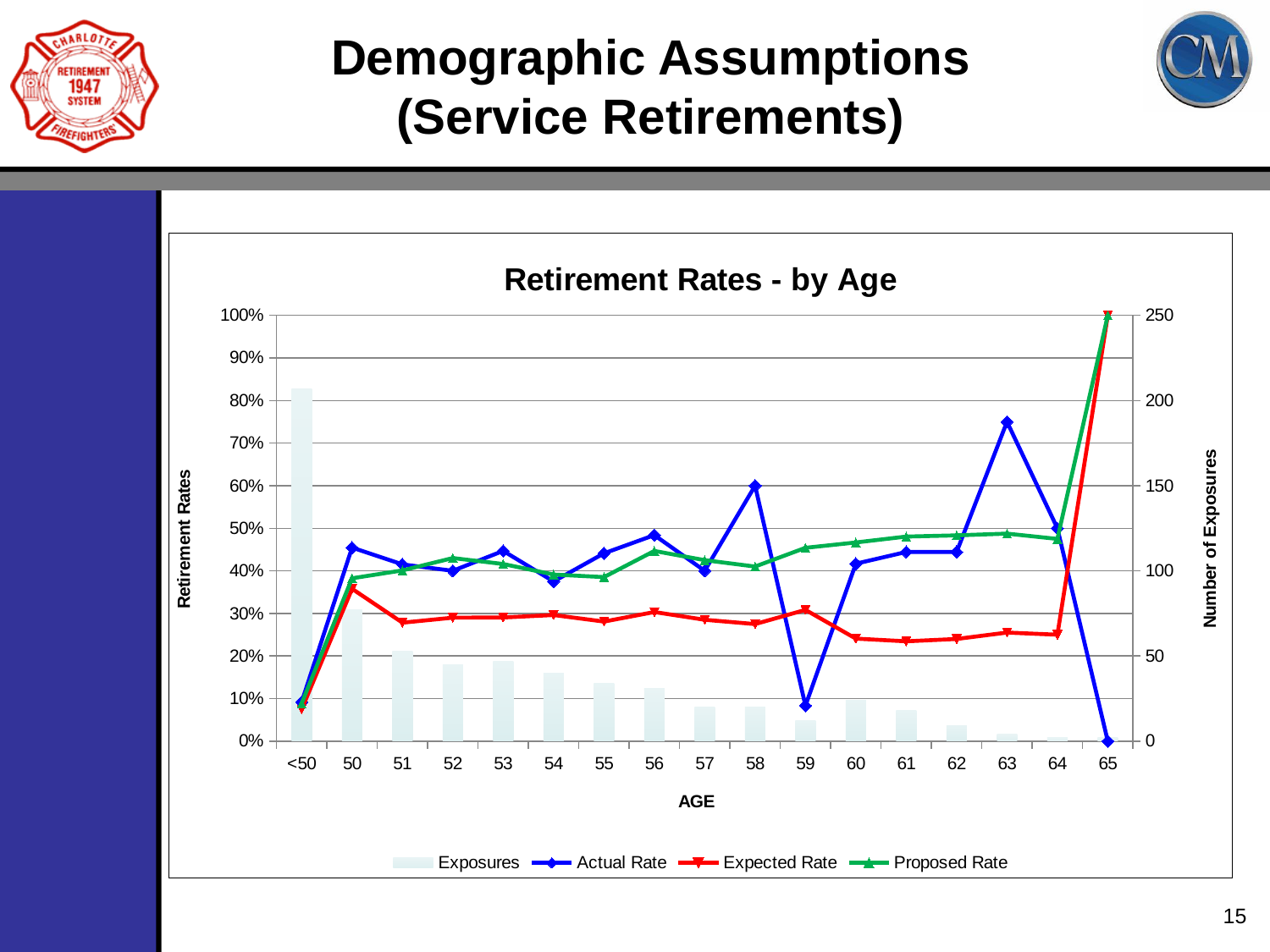
How many series does the chart legend list? 4 What is the title of the chart? Retirement Rates - by Age How many age categories are shown on the x axis? 17 Do the Exposures generally rise or fall as age increases from 50 to 65? fall Which age category has the highest number of Exposures? <50 What kind of chart is this? Combined bar and line chart What is the Proposed Rate at age 65? 100% What is the Actual Rate at age 65? 0% Is the Actual Rate at age 63 greater or less than 70%? greater What is the Expected Rate at age 65? 100% Is the number of Exposures for the <50 category greater or less than 200? greater At age 63, which is larger, the Actual Rate or the Expected Rate? Actual Rate